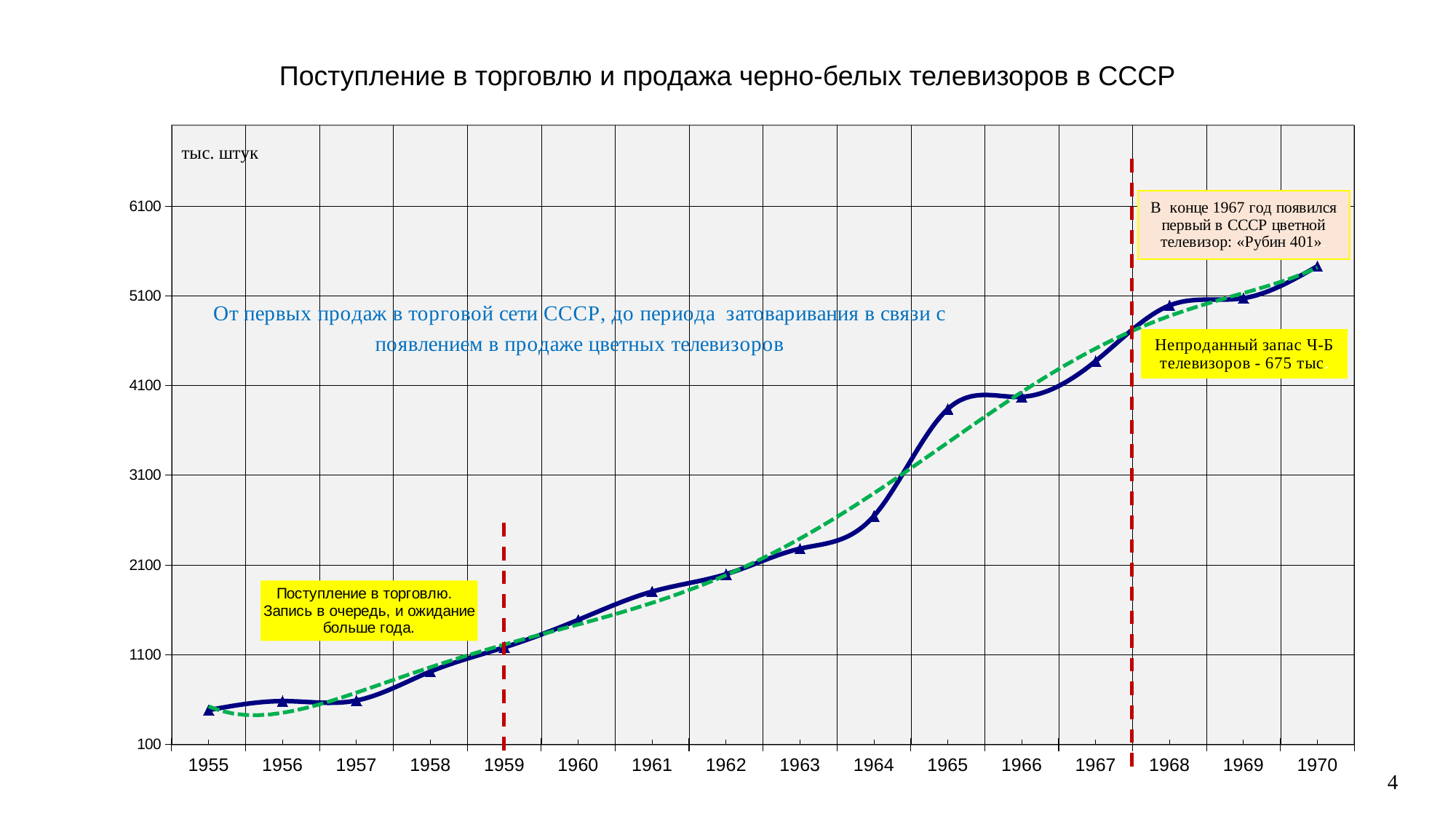
What unit is indicated for the values on the chart? тыс. штук Is the value for 1970 greater or less than 5100? greater Do the values generally rise or fall from 1955 to 1970? rise Is the value for 1961 greater or less than 2100? less Which year has the highest value on the chart? 1970 Is the value for 1965 greater or less than 3100? greater Which year has the lowest value on the chart? 1955 What is the title of the chart? Поступление в торговлю и продажа черно-белых телевизоров в СССР What kind of chart is shown on the slide? line chart How many years (data points) are plotted along the x axis? 16 Which year has the larger value, 1964 or 1965? 1965